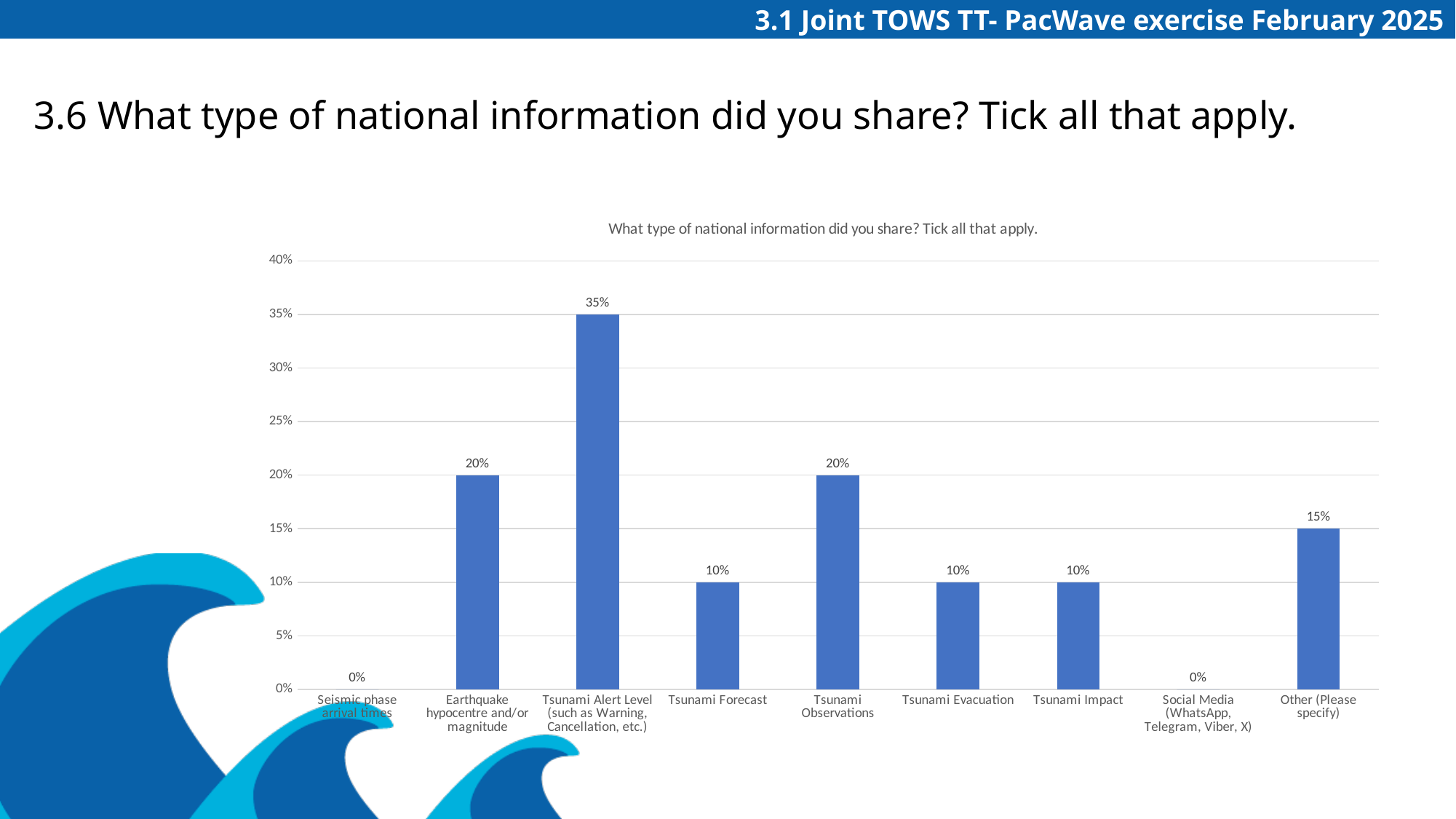
What is the value for Other (Please specify)? 15% What is the difference between the values for Other (Please specify) and Tsunami Impact? 5% How many categories have a value of 0%? 2 What is the value for Tsunami Alert Level (such as Warning, Cancellation, etc.)? 35% How many categories are shown on the x axis? 9 What is the difference between the values for Tsunami Alert Level and Earthquake hypocentre and/or magnitude? 15% Which category has the highest value? Tsunami Alert Level (such as Warning, Cancellation, etc.) What is the value for Social Media (WhatsApp, Telegram, Viber, X)? 0% What kind of chart is shown on the slide? Bar chart What is the title of the chart? What type of national information did you share? Tick all that apply. What is the value for Tsunami Forecast? 10% Which is larger, the value for Tsunami Observations or the value for Tsunami Evacuation? Tsunami Observations